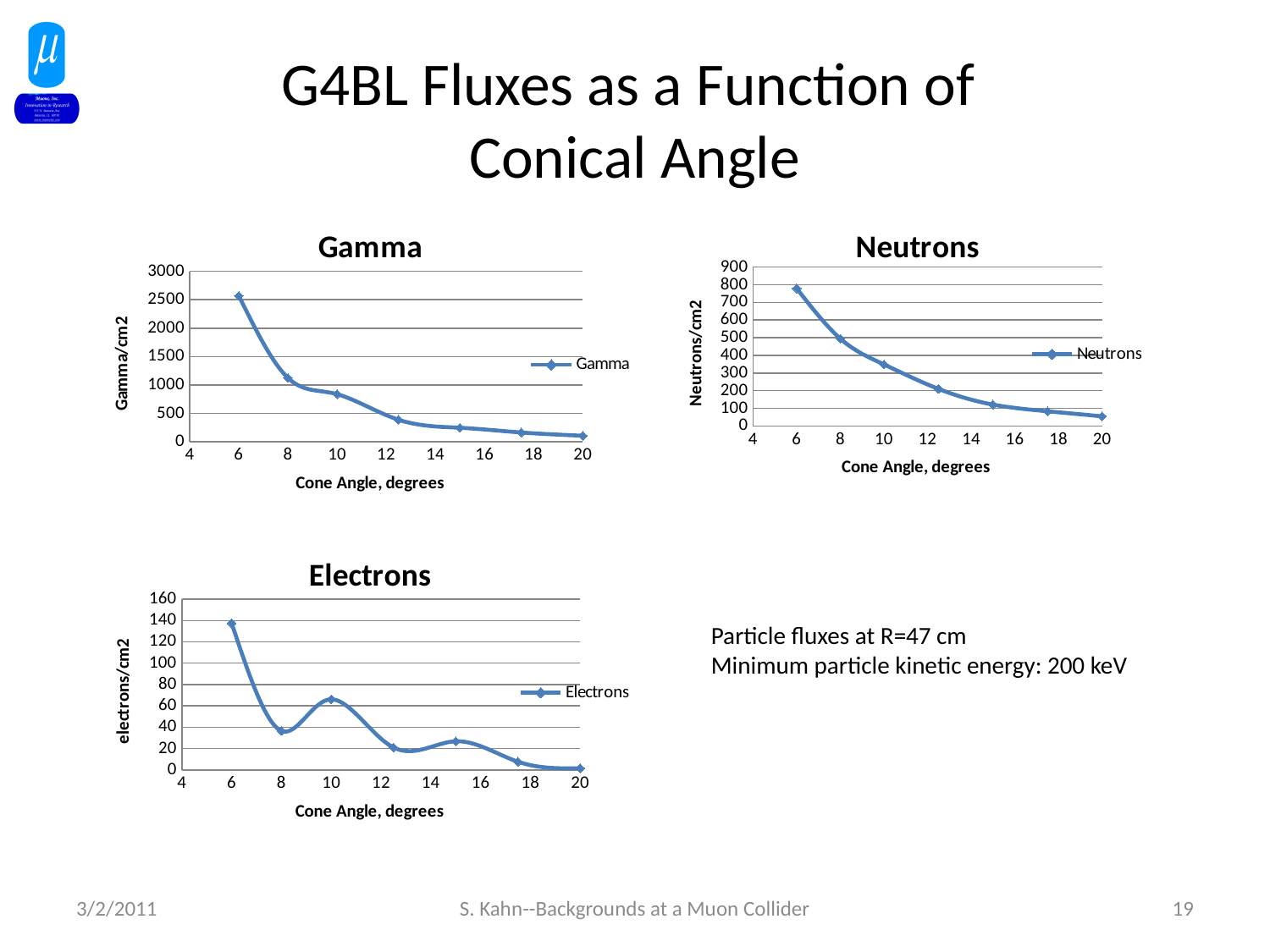
How many series does the legend of the Neutrons chart list? 1 In the Gamma chart, is the value at a cone angle of 20 degrees greater or less than 500? less How many data points are plotted in the Electrons chart? 7 What is the x-axis label of the Gamma chart? Cone Angle, degrees In the Electrons chart, which is larger: the value at 8 degrees or the value at 10 degrees? 10 degrees In the Gamma chart, do the values rise or fall as the cone angle increases? fall In the Gamma chart, is the value at a cone angle of 6 degrees greater or less than 2000? greater What kind of chart is the Gamma chart? line chart In the Neutrons chart, is the value at a cone angle of 8 degrees greater or less than 400? greater In the Neutrons chart, at which cone angle is the neutron flux highest? 6